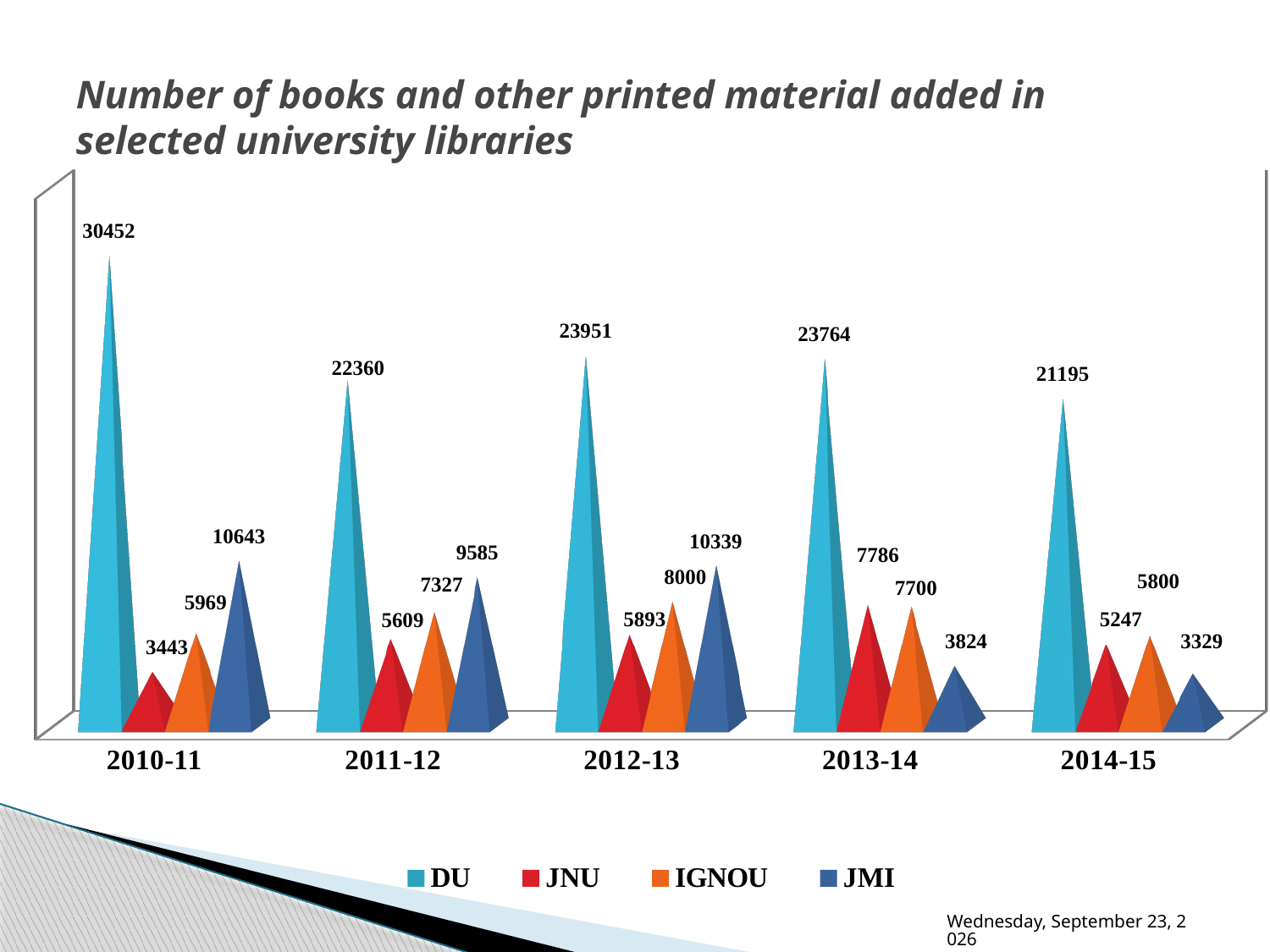
What is the value for IGNOU in 2014-15? 5800 What is the value for DU in 2010-11? 30452 How many years are shown on the x axis? 5 What is the difference between the DU value and the JMI value in 2011-12? 12775 What is the value for JMI in 2012-13? 10339 Which is larger in 2013-14, the JNU value or the IGNOU value? JNU Which colour represents IGNOU in the legend? orange What kind of chart is shown on the slide? bar chart How many series does the legend list? 4 In which year is the DU value highest? 2010-11 In which year is the JNU value lowest? 2010-11 Does the JMI value rise or fall from 2012-13 to 2014-15? fall